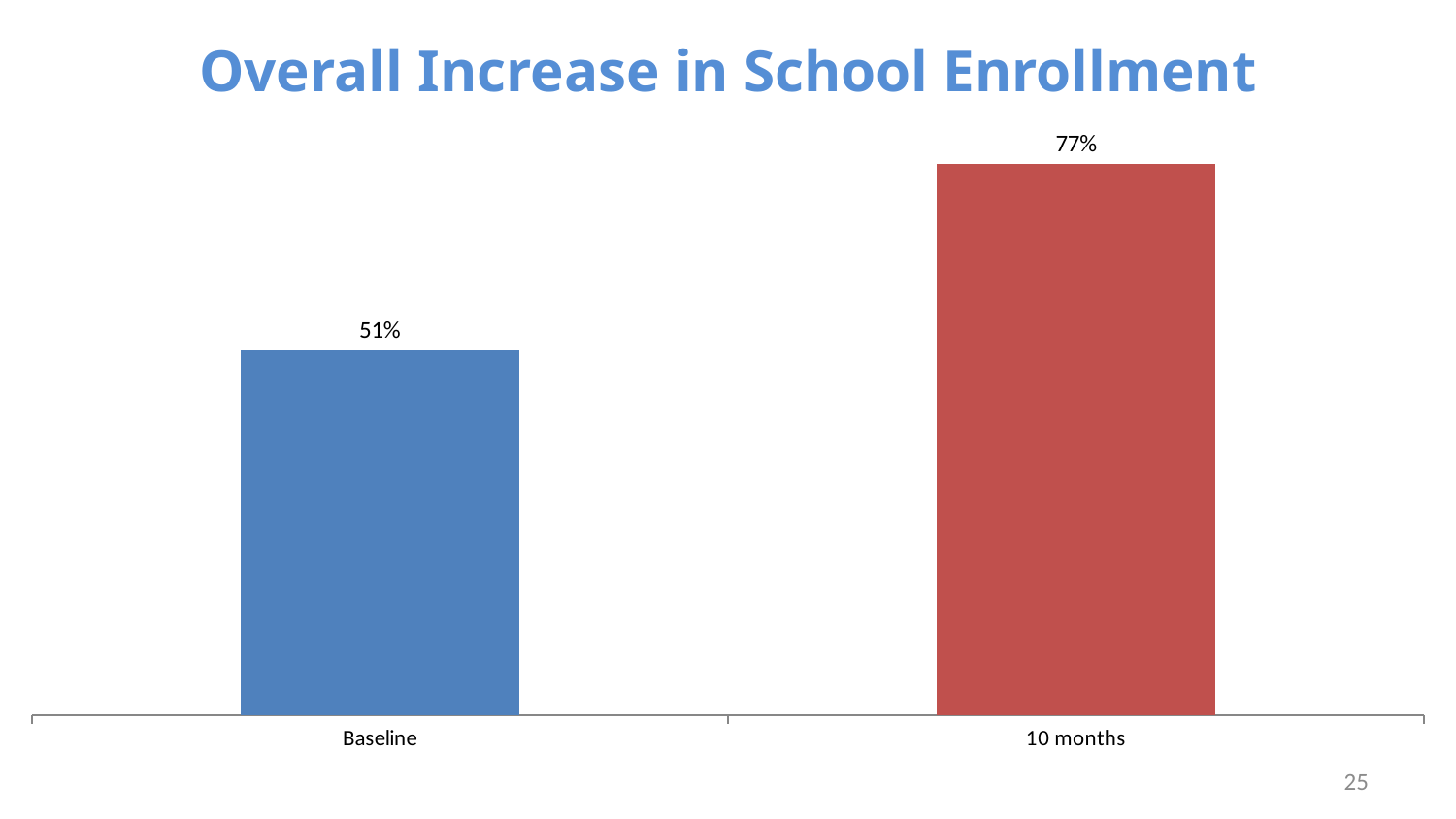
What is the value for 10 months? 77% What colour is the bar for 10 months? Red What is the difference between the value for 10 months and the value for Baseline? 26% Do the values rise or fall from Baseline to 10 months? Rise Which category has the lowest value? Baseline How many categories are shown on the x axis? 2 What kind of chart is shown on the slide? Bar chart What is the title of the slide? Overall Increase in School Enrollment What is the value for Baseline? 51% Which category has the highest value? 10 months Which is larger, the value for Baseline or the value for 10 months? 10 months